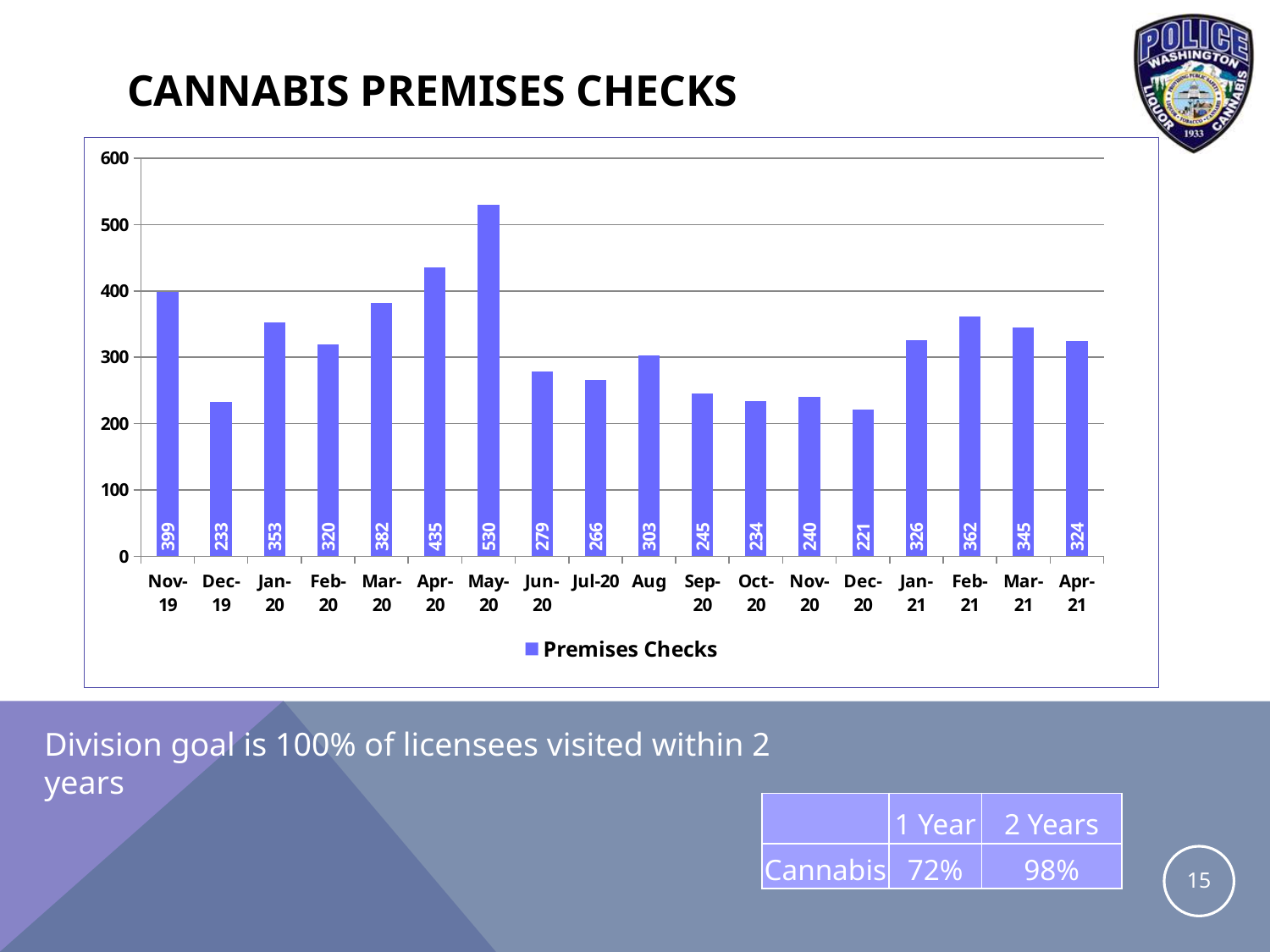
Is the value for Jun-20 greater or less than 300? less What is the title of the chart on the slide? CANNABIS PREMISES CHECKS Which has more Premises Checks, Mar-20 or Mar-21? Mar-20 Which month has the highest number of Premises Checks? May-20 What is the difference in Premises Checks between Nov-19 and Dec-19? 166 What is the value of Premises Checks for May-20? 530 Which month has the lowest number of Premises Checks? Dec-20 What is the value of Premises Checks for Feb-21? 362 How many months are shown on the x axis of the chart? 18 What is the value of Premises Checks for Dec-20? 221 What is the difference in Premises Checks between May-20 and Apr-20? 95 What type of chart is shown on the slide? bar chart